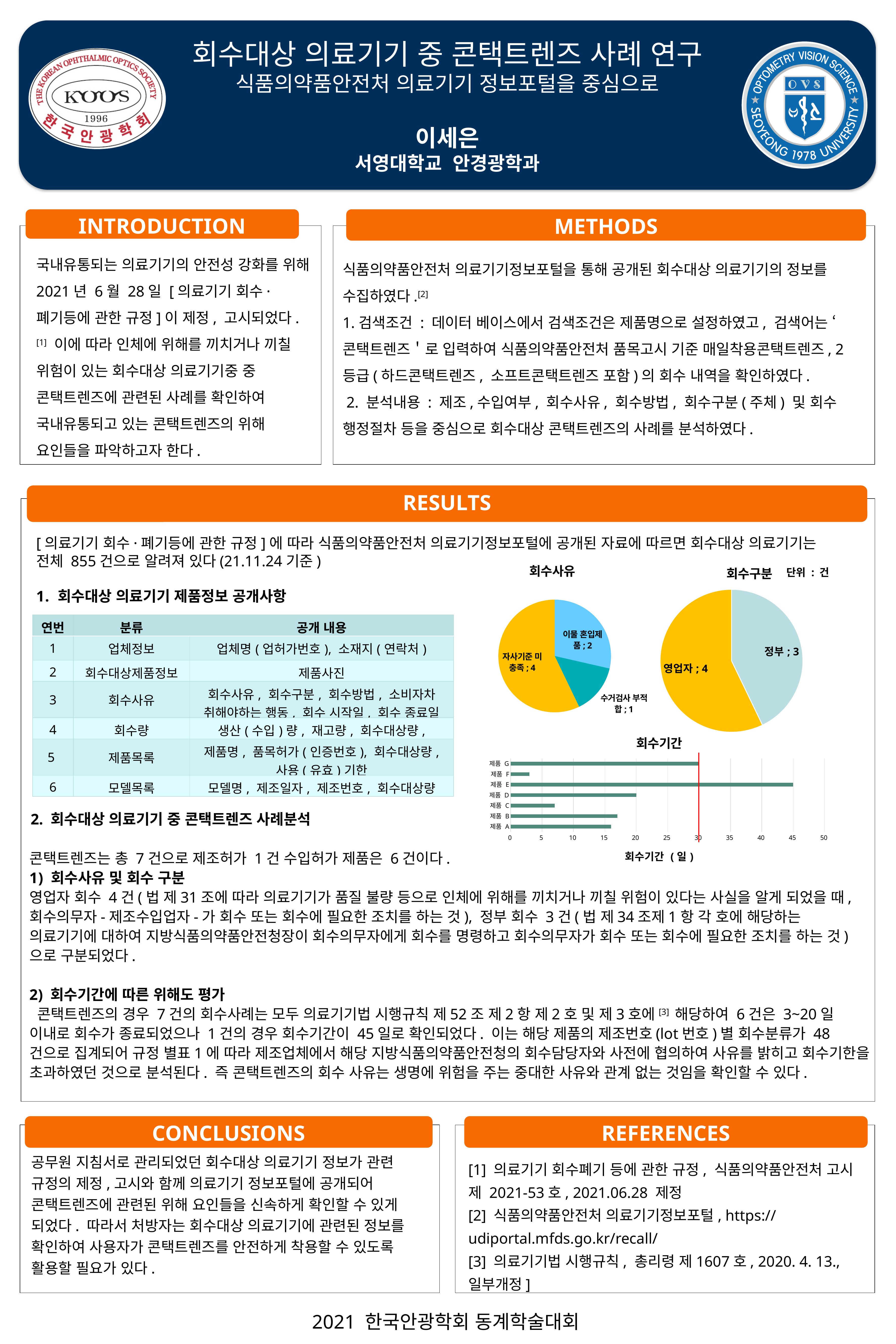
In the 회수사유 pie chart, what is the value for 이물 혼입제품? 2 In the 회수구분 pie chart, what is the difference between 영업자 and 정부? 1 In the 회수기간 bar chart, which product has the shortest recall period? 제품 F In the 회수사유 pie chart, what is the value for 자사기준 미충족? 4 What kind of chart is the 회수기간 chart? bar chart In the 회수사유 pie chart, which category has the smallest value? 수거검사 부적합 In the 회수구분 pie chart, what is the value for 영업자? 4 In the 회수기간 bar chart, is the value for 제품 E greater or less than 40? greater In the 회수기간 bar chart, how many products are shown? 7 In the 회수사유 pie chart, how many slices are there? 3 In the 회수기간 bar chart, which product has the longest recall period? 제품 E In the 회수구분 pie chart, which is larger, 영업자 or 정부? 영업자